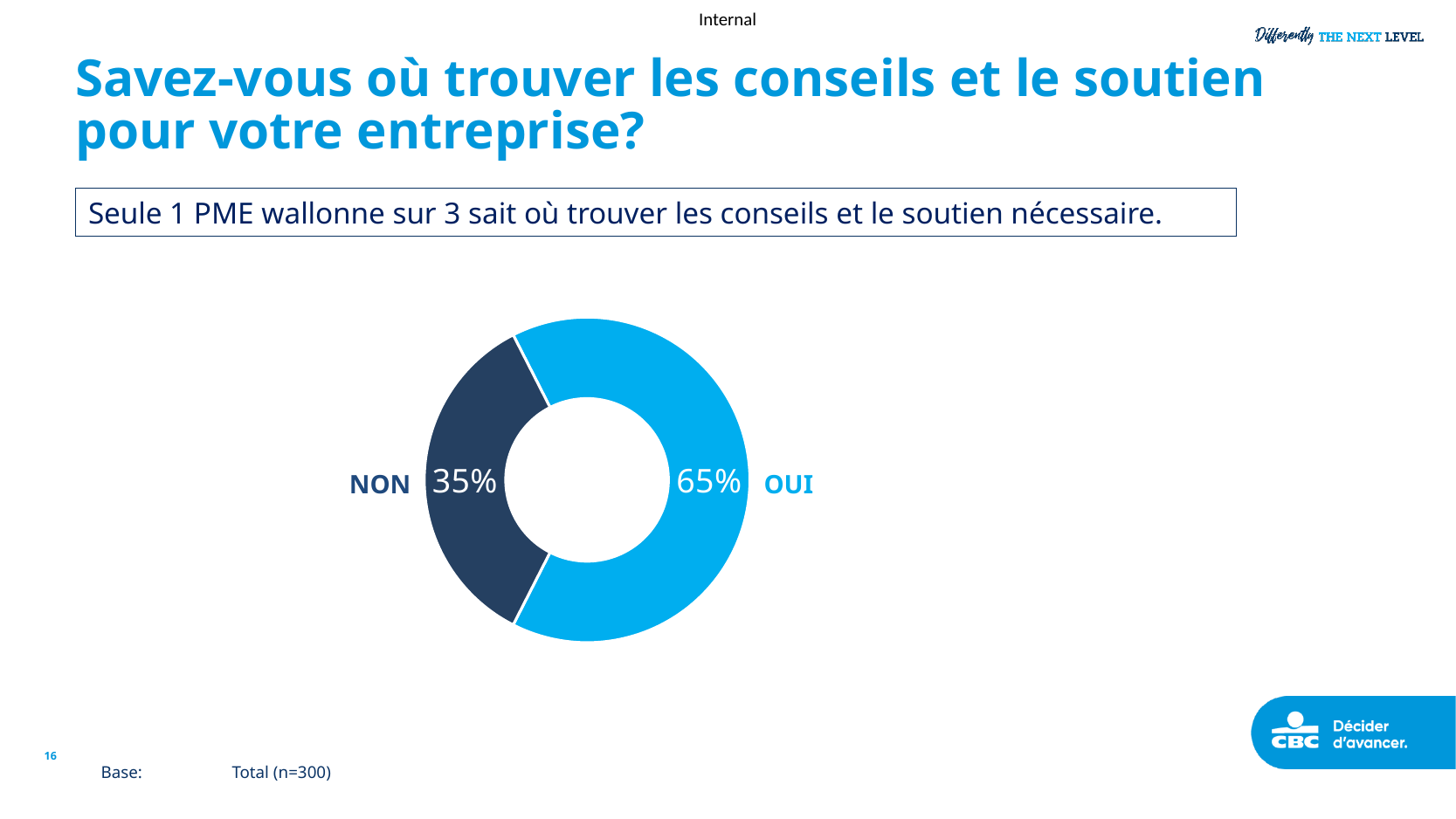
What percentage of respondents answered NON? 35% What share of the chart does the OUI slice represent? 65% What percentage of respondents answered OUI? 65% Which colour is used for the NON slice? Dark navy blue Which category has the largest share in the chart? OUI What is the sample size (base) stated for the chart? Total (n=300) What kind of chart is shown on the slide? Doughnut chart Which category has the smallest share in the chart? NON Which response has the larger share, OUI or NON? OUI What is the difference in percentage points between the OUI and NON shares? 30 How many categories are shown in the chart? 2